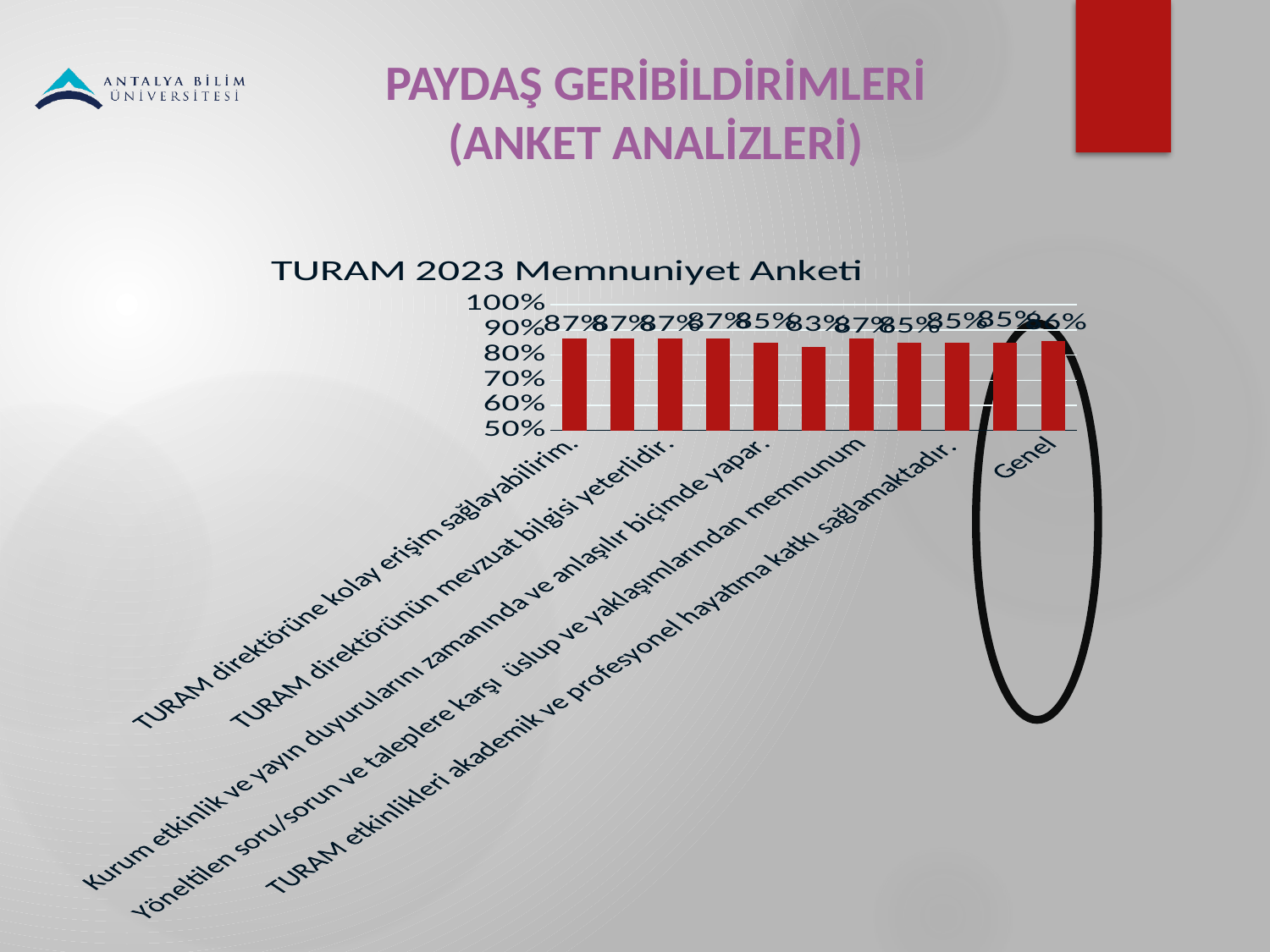
What is the lowest value shown on the chart? 83% What is the value for the 'Genel' category? 86% What is the highest value shown on the chart? 87% What is the value for 'TURAM direktörüne kolay erişim sağlayabilirim.'? 87% What is the title of the chart? TURAM 2023 Memnuniyet Anketi How many bars are plotted in the chart? 11 Which is larger, the value for 'TURAM direktörüne kolay erişim sağlayabilirim.' or the value for 'Genel'? TURAM direktörüne kolay erişim sağlayabilirim. What is the lowest value shown on the vertical axis? 50% Is the value for 'Genel' greater or less than 80%? greater What kind of chart is shown on the slide? bar chart What is the difference between the 'Genel' value and the lowest value on the chart? 3 percentage points